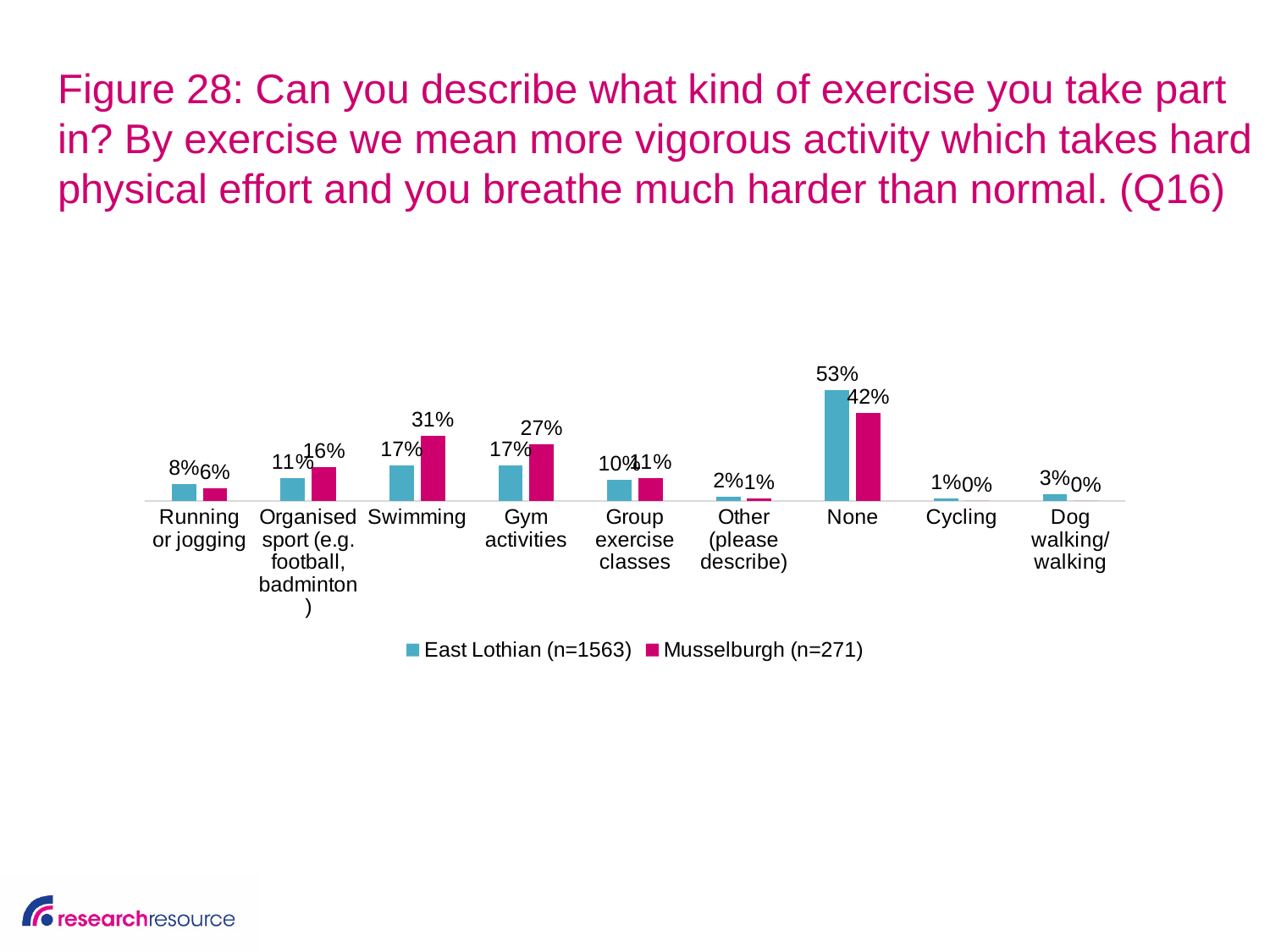
For organised sport, which area has the larger value, East Lothian or Musselburgh? Musselburgh What percentage of East Lothian respondents said they take part in swimming? 17% How many exercise categories are shown on the x axis? 9 Which category has the highest value for Musselburgh? None How many series does the legend list? 2 What is the difference between the East Lothian and Musselburgh values for swimming? 14% What is the difference between the East Lothian and Musselburgh values for 'None'? 11% Which category has the highest value for East Lothian? None What is the value for Musselburgh for 'None'? 42% Which category has the lowest value for East Lothian? Cycling What percentage of Musselburgh respondents said they take part in gym activities? 27% What kind of chart is shown on the slide? Bar chart